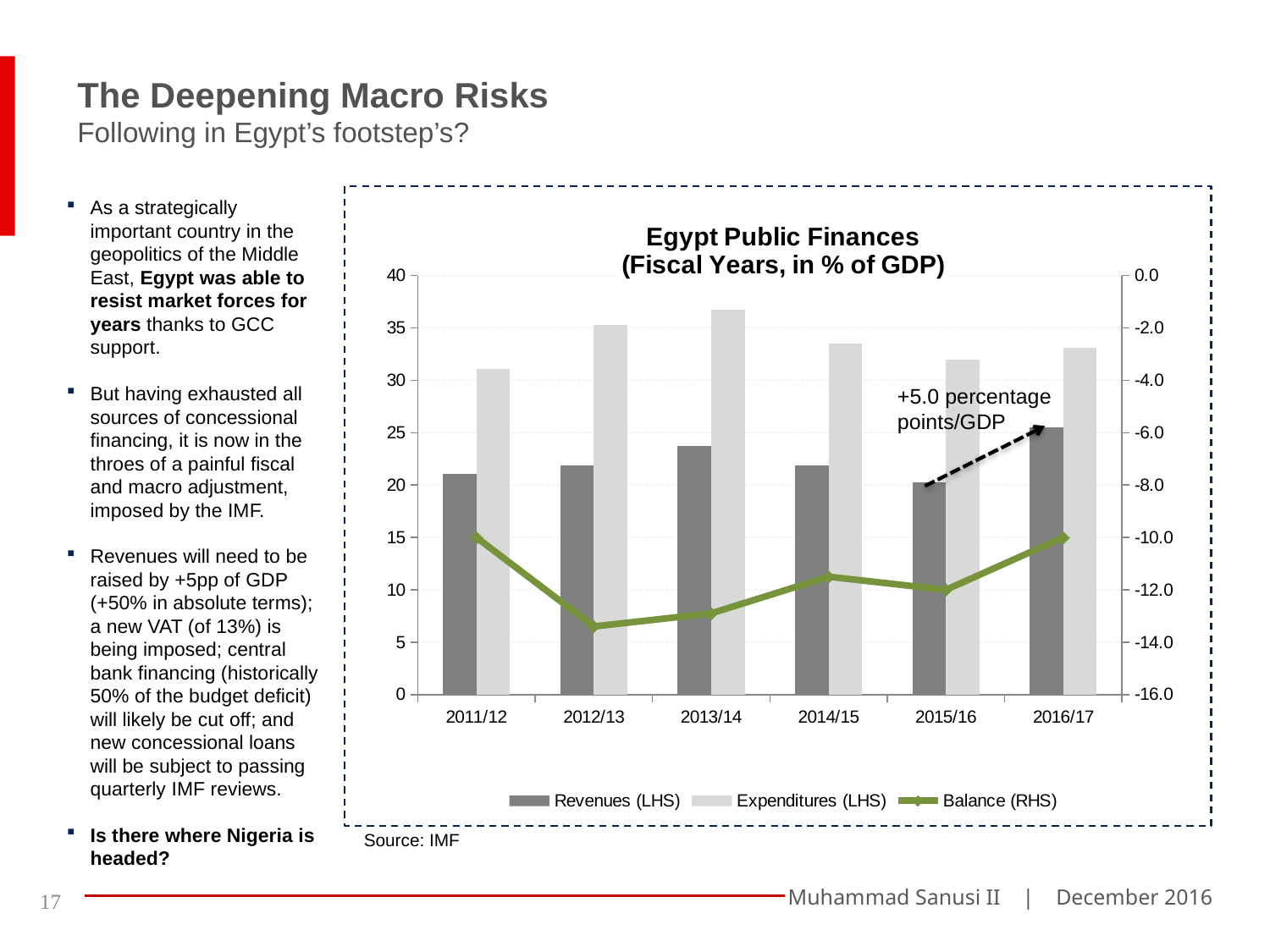
Is the value for Expenditures (LHS) in 2013/14 greater or less than 35? greater Is the value for Expenditures (LHS) in 2011/12 greater or less than 30? greater Which is larger in 2014/15, Revenues (LHS) or Expenditures (LHS)? Expenditures (LHS) How many fiscal years are shown on the x axis? 6 In which fiscal year are Revenues (LHS) highest? 2016/17 How many series does the legend list? 3 Does the Balance (RHS) line rise or fall from 2015/16 to 2016/17? Rise What kind of chart is used to show Revenues and Expenditures? Bar chart Is the value for Revenues (LHS) in 2011/12 greater or less than 25? less What change in revenues does the annotation with the dashed arrow indicate? +5.0 percentage points/GDP What is the title of the chart? Egypt Public Finances (Fiscal Years, in % of GDP) In which fiscal year are Expenditures (LHS) highest? 2013/14